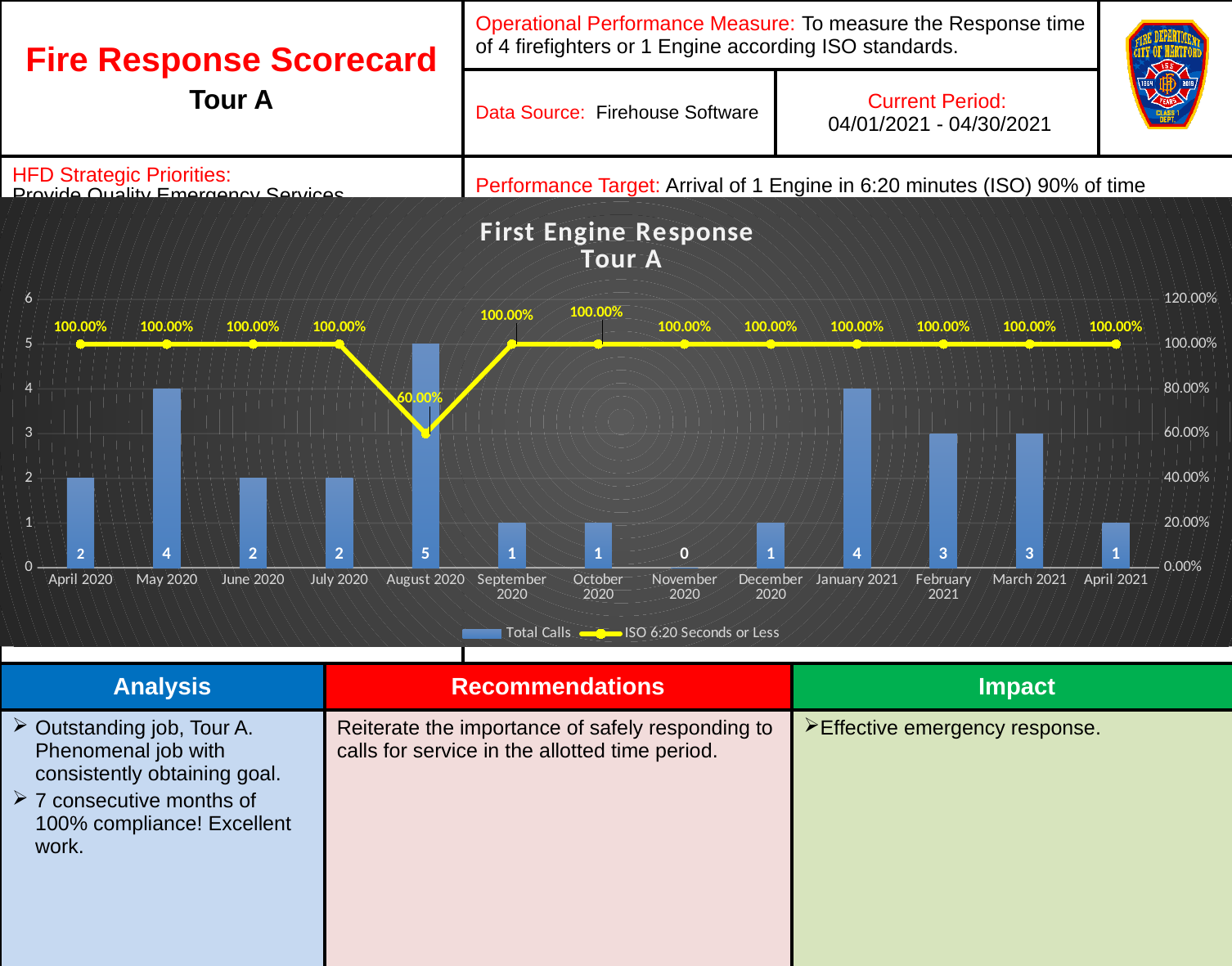
What is the title of the chart? First Engine Response Tour A How many series does the legend list? 2 Which month has the lowest number of Total Calls? November 2020 How many months are shown on the x axis? 13 How many Total Calls were there in January 2021? 4 Which month is the only one where the ISO 6:20 Seconds or Less value is below 100.00%? August 2020 What kind of chart is used for the Total Calls series? Bar chart Which month has the highest number of Total Calls? August 2020 How many Total Calls were there in August 2020? 5 What is the difference in Total Calls between May 2020 and April 2021? 3 Which month has more Total Calls, February 2021 or December 2020? February 2021 What is the ISO 6:20 Seconds or Less value for August 2020? 60.00%